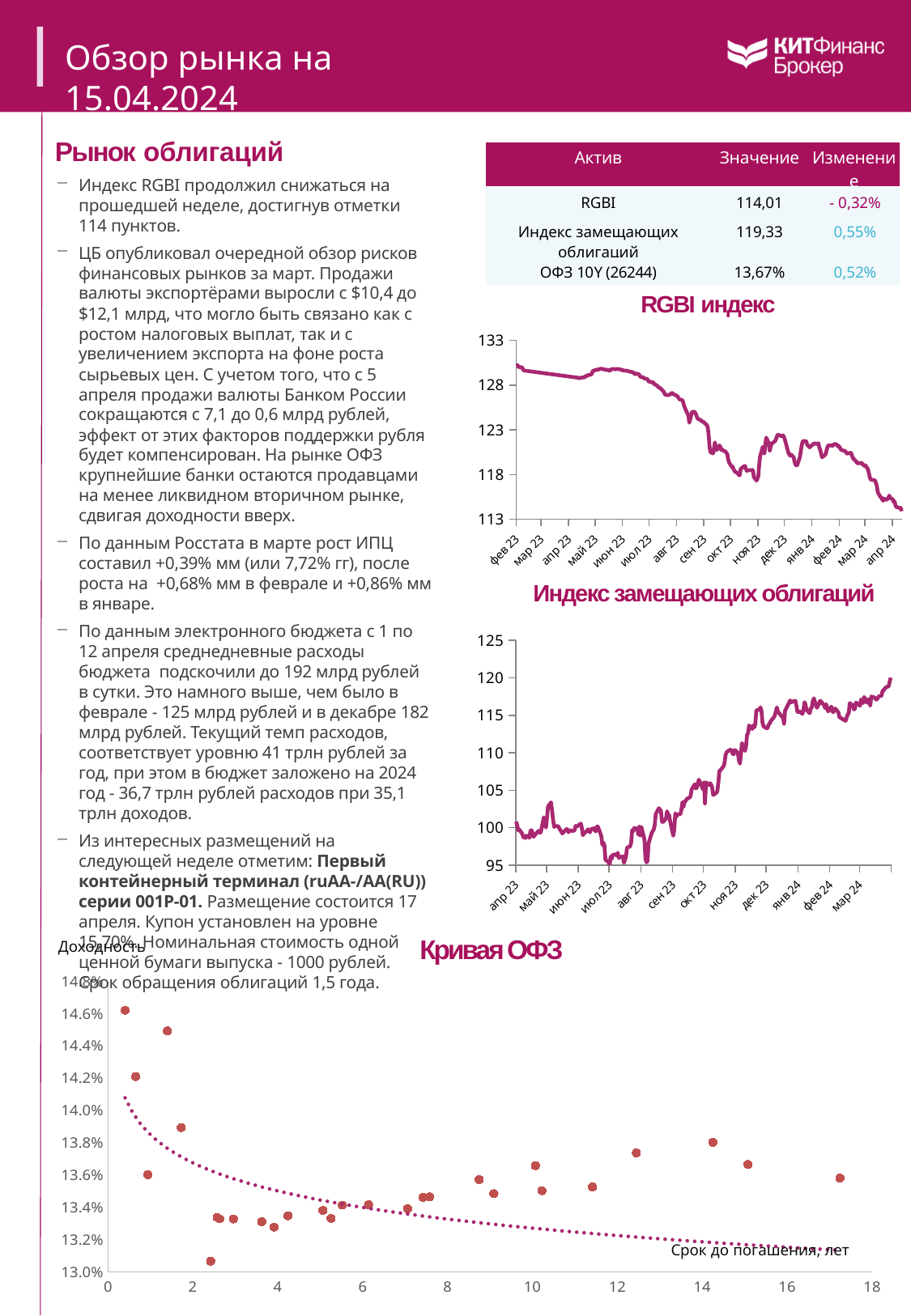
What is the highest value shown on the y axis of the "Индекс замещающих облигаций" chart? 125 On the "RGBI индекс" chart, is the value at фев 23 greater or less than 128? greater On the "Индекс замещающих облигаций" chart, do the values generally rise or fall from апр 23 to мар 24? rise How many month labels are shown on the x axis of the "RGBI индекс" chart? 15 On the "RGBI индекс" chart, is the value at апр 24 greater or less than 118? less What kind of chart is the "RGBI индекс" chart? line chart On the "Индекс замещающих облигаций" chart, is the value at апр 23 greater or less than 105? less What is the label of the x axis on the "Кривая ОФЗ" chart? Срок до погашения, лет On the "Кривая ОФЗ" chart, does the dotted trend line rise or fall as the term to maturity increases? fall On the "RGBI индекс" chart, do the values generally rise or fall from фев 23 to апр 24? fall What kind of chart is the "Кривая ОФЗ" chart? scatter chart